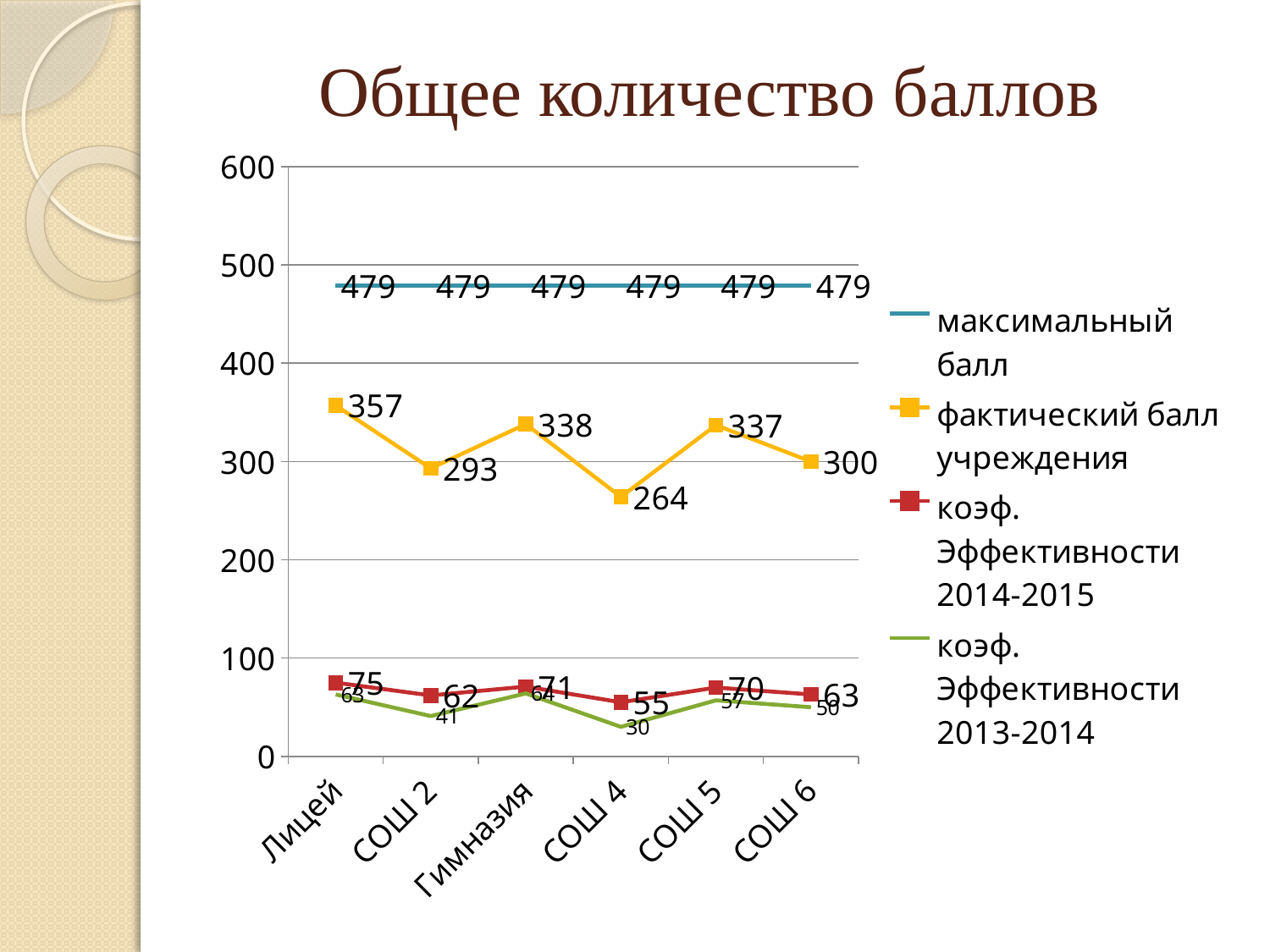
What is the максимальный балл value for Лицей? 479 What is the difference between the фактический балл учреждения for Лицей and for СОШ 2? 64 Which category has the lowest фактический балл учреждения? СОШ 4 What is the title of the chart? Общее количество баллов How many categories are shown on the x axis? 6 Is the фактический балл учреждения for СОШ 6 greater or less than 400? less What is the фактический балл учреждения for Гимназия? 338 Which category has the highest фактический балл учреждения? Лицей What kind of chart is shown on the slide? line chart Which is larger, the коэф. Эффективности 2014-2015 for СОШ 5 or for СОШ 6? СОШ 5 How many series does the legend list? 4 What is the коэф. Эффективности 2014-2015 value for СОШ 4? 55